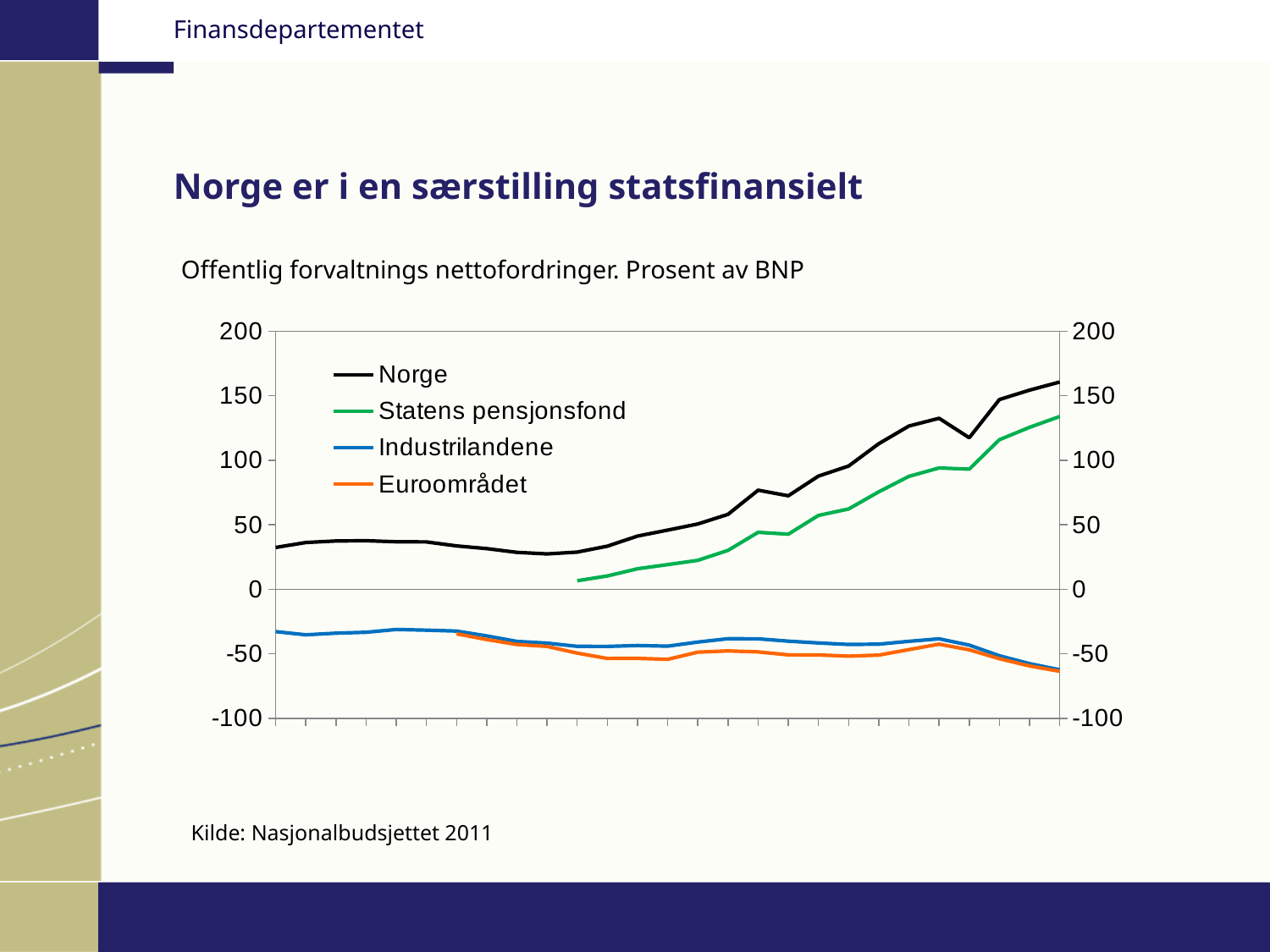
Which two series stay below 0 throughout the chart? Industrilandene and Euroområdet At the right end of the chart, is the value for Norge greater or less than 150? greater Which series has the highest value at the right end of the chart? Norge What is the subtitle describing what the chart shows? Offentlig forvaltnings nettofordringer. Prosent av BNP What kind of chart is shown on the slide? line chart At the right end of the chart, is the value for Statens pensjonsfond greater or less than 100? greater At the right end of the chart, is the value for Industrilandene greater or less than -50? less How many series does the legend list? 4 Does the Industrilandene line rise or fall overall from left to right? fall At the right end of the chart, which is larger: Norge or Statens pensjonsfond? Norge What colour is the line for Statens pensjonsfond? green Does the Norge line rise or fall overall from left to right? rise